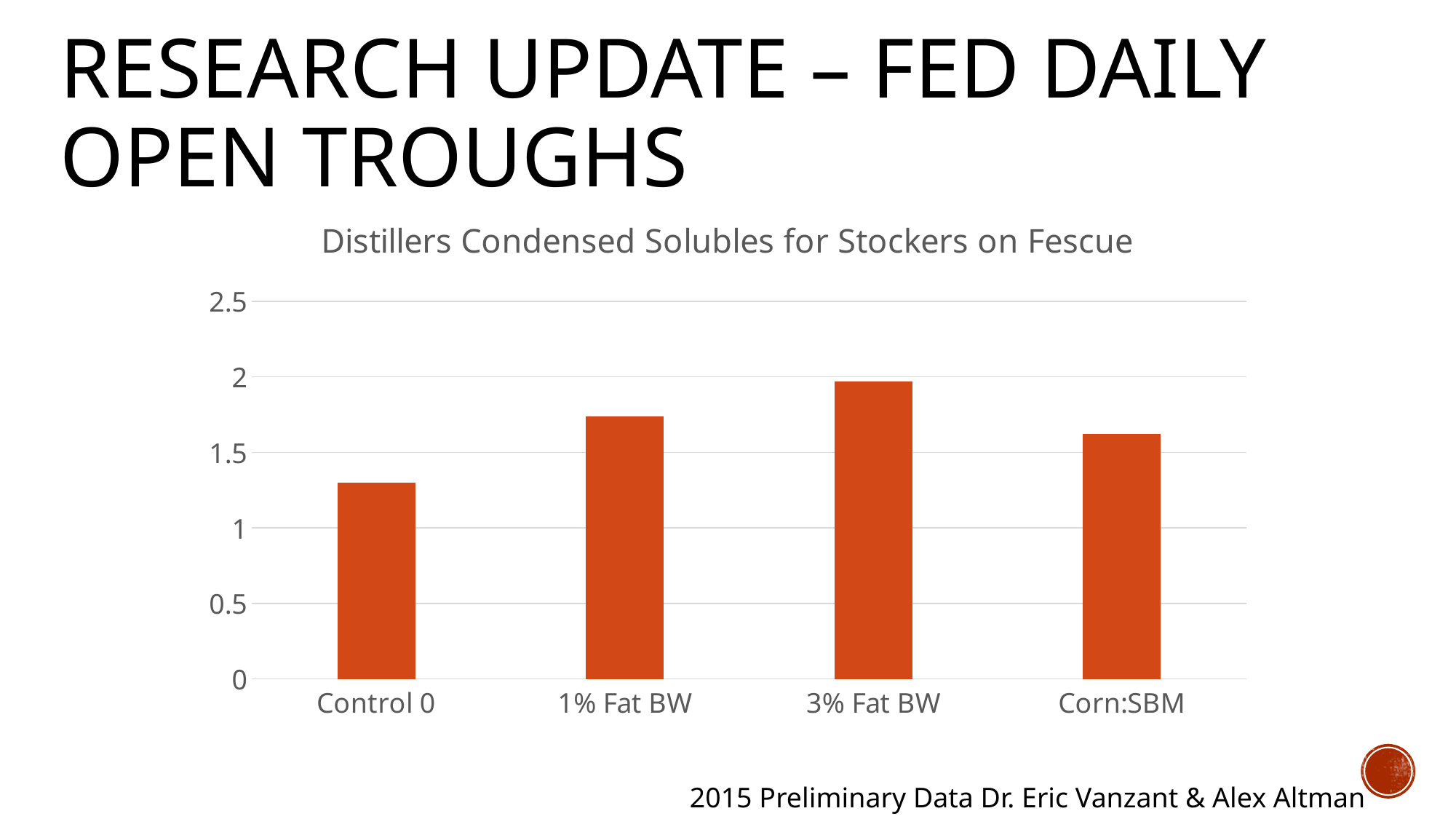
Is the value for Corn:SBM greater or less than 1.5? greater Is the value for Control 0 greater or less than 1.5? less Which is larger, the value for Control 0 or the value for Corn:SBM? Corn:SBM How many categories are plotted on the x axis? 4 Which category has the highest bar? 3% Fat BW What kind of chart is shown on the slide? bar chart What is the title of the chart? Distillers Condensed Solubles for Stockers on Fescue Is the value for 1% Fat BW greater or less than 1.5? greater Which category has the lowest bar? Control 0 Which is larger, the value for 1% Fat BW or the value for Corn:SBM? 1% Fat BW Do the values rise or fall from Control 0 to 3% Fat BW? rise